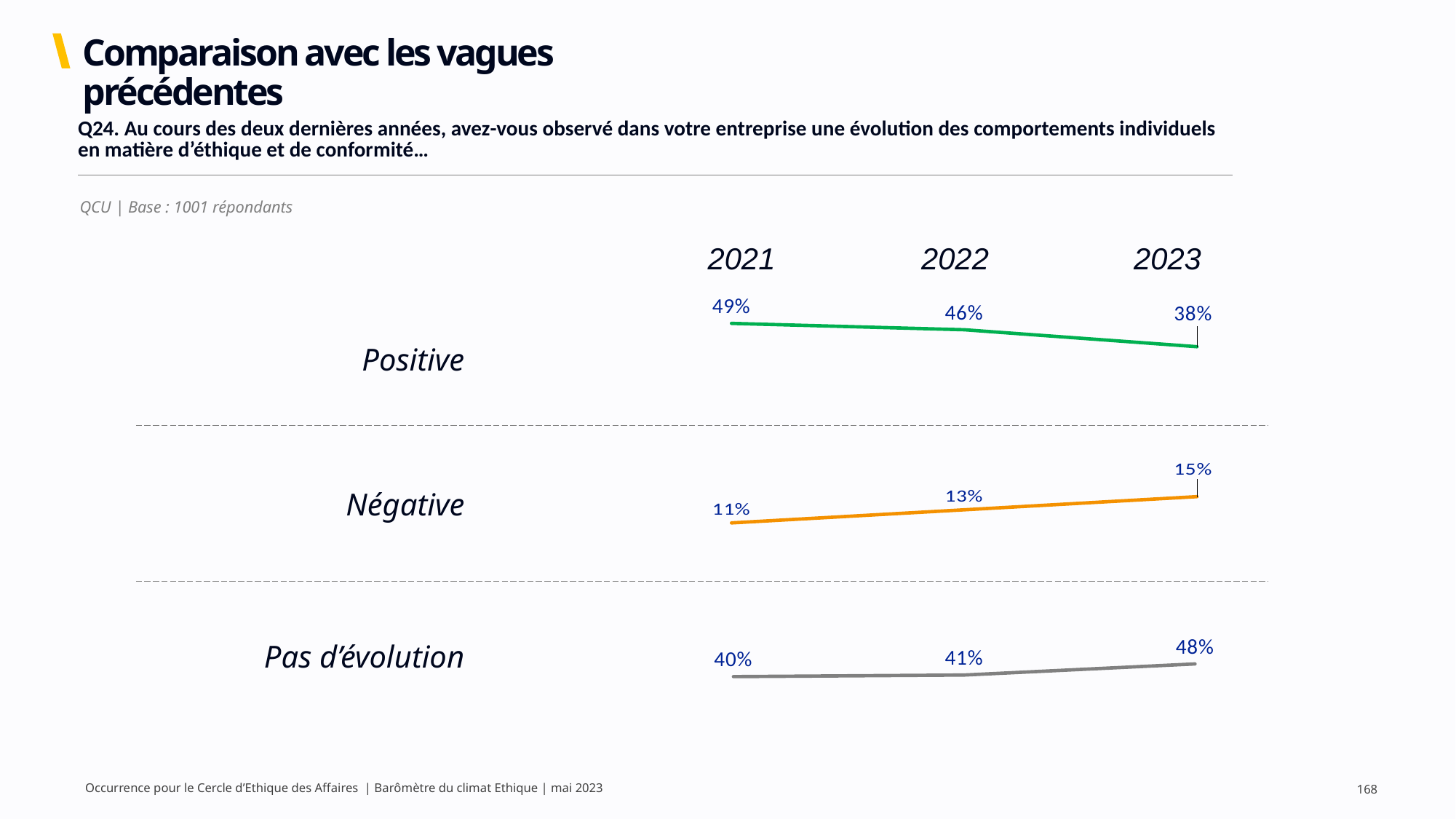
In the Pas d'évolution chart, what is the value for 2023? 48% In the Négative chart, which year has the highest value? 2023 What kind of chart is used for the Négative series? line chart In the Positive chart, what is the difference between the 2021 and 2023 values? 11 percentage points In the Positive chart, what is the value for 2021? 49% In the Négative chart, what is the value for 2022? 13% In the Positive chart, do the values rise or fall from 2021 to 2023? fall In the Positive chart, how many data points are plotted? 3 In the Pas d'évolution chart, which year has the lowest value? 2021 In the Pas d'évolution chart, what is the difference between the 2022 and 2023 values? 7 percentage points In the Négative chart, do the values rise or fall from 2021 to 2023? rise In the Positive chart, what is the value for 2023? 38%